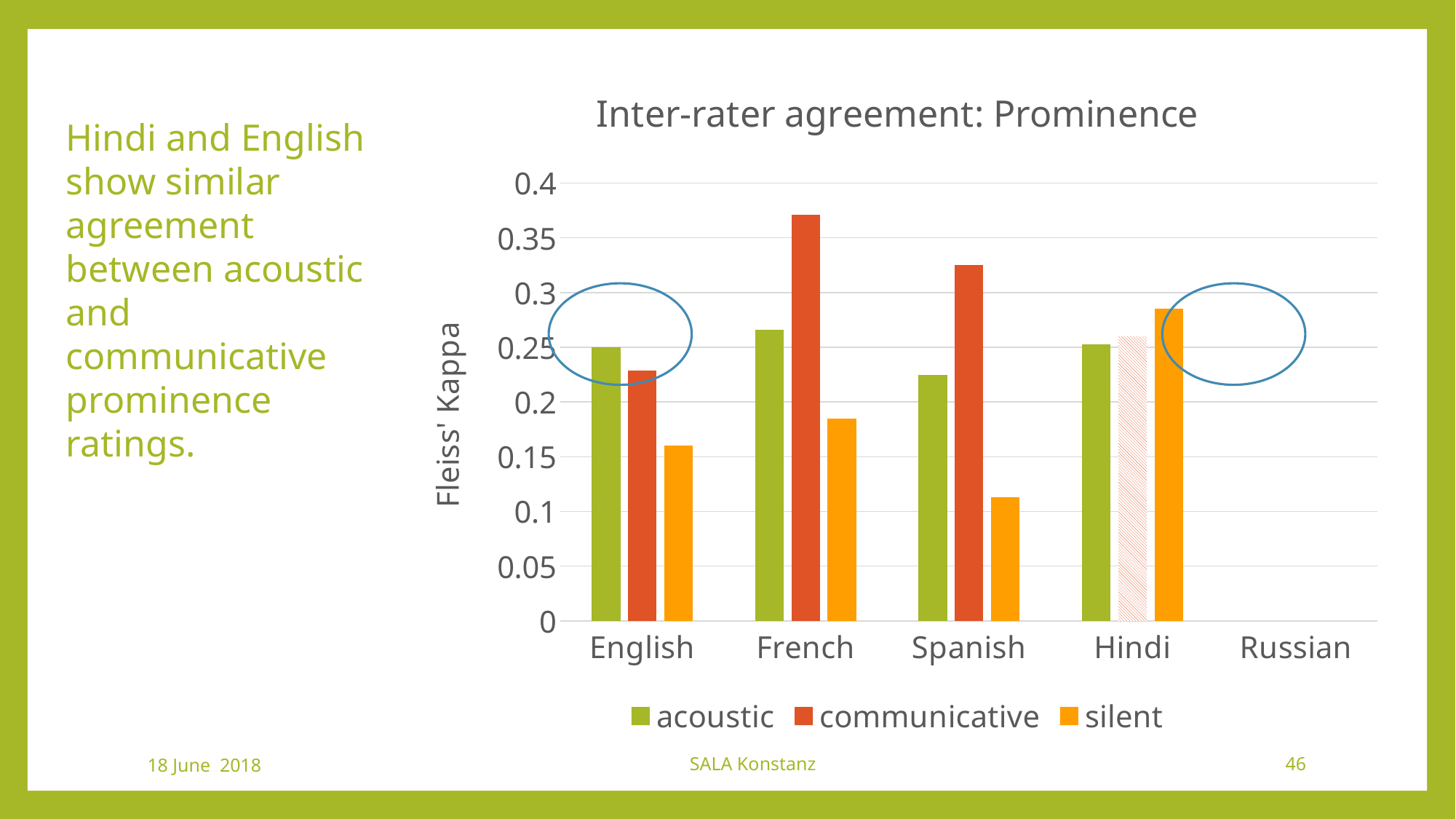
What kind of chart is shown on the slide? bar chart Which language has the highest communicative value? French How many languages are labelled on the x axis? 5 Is the silent value for Spanish greater or less than 0.15? less Which is larger, the communicative value for French or for Spanish? French Is the silent value for Hindi greater or less than 0.25? greater Which is larger, the silent value for English or for French? French What is the title of the chart? Inter-rater agreement: Prominence How many series does the legend list? 3 For Spanish, which series has the highest bar? communicative Is the communicative value for French greater or less than 0.35? greater Which language has the lowest silent value? Spanish